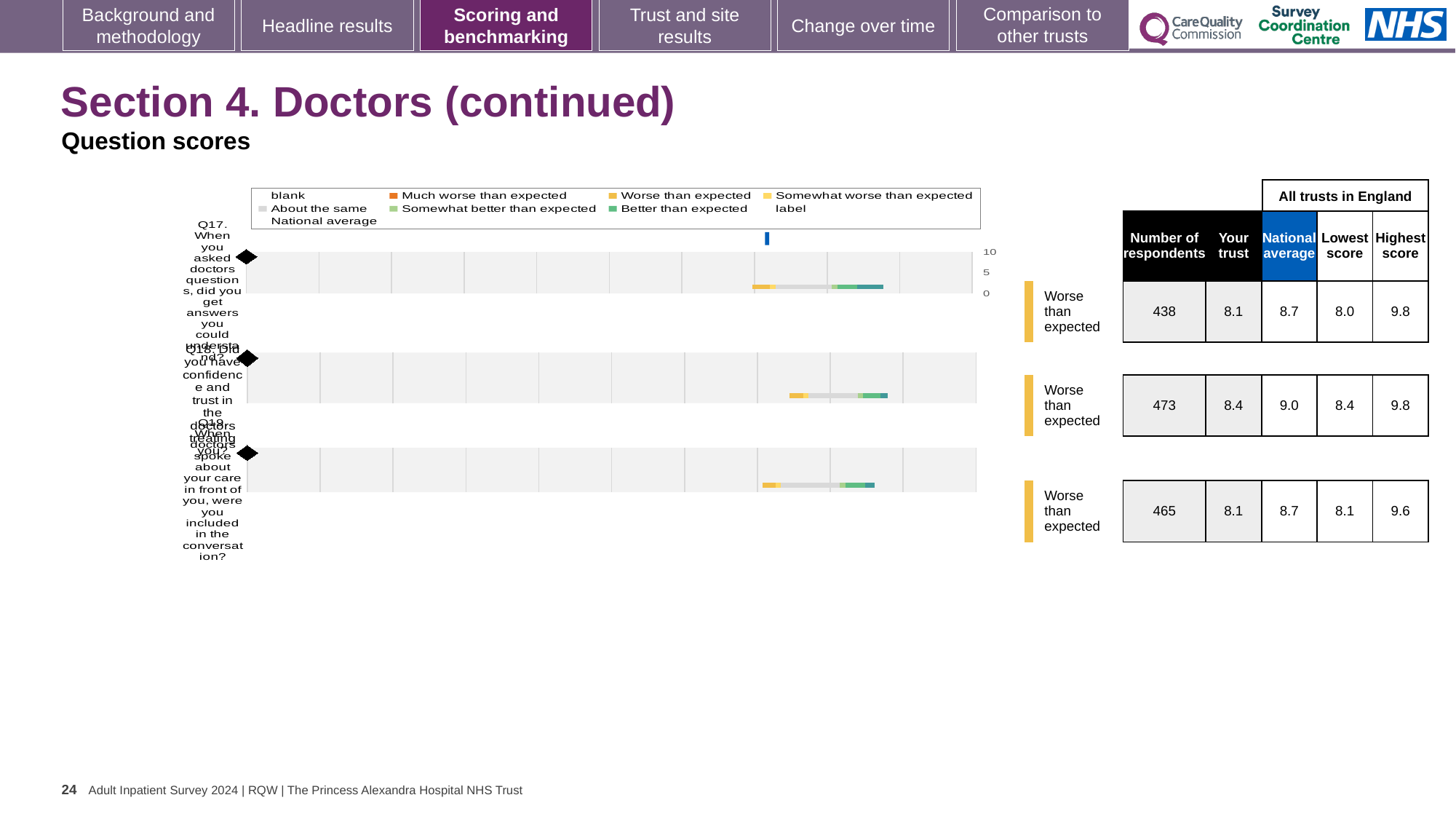
For Q17, is the 'Your trust' score higher or lower than the national average? lower How many respondents answered Q19 (When doctors spoke about your care in front of you, were you included in the conversation?)? 465 Which of the three questions has the highest 'Your trust' score? Q18 How many question charts (Q17, Q18, Q19) are shown on the slide? 3 What is the lowest score across all trusts in England for Q17? 8.0 Which of the three questions has the most respondents? Q18 What benchmark category is shown for Q17 (When you asked doctors questions, did you get answers you could understand?)? Worse than expected What is the difference between the national average and the 'Your trust' score for Q18? 0.6 What is the highest score across all trusts in England for Q19? 9.6 What is the 'Your trust' score for Q18 (Did you have confidence and trust in the doctors treating you?)? 8.4 Is the 'Your trust' score for Q17 greater or less than 5 on the chart axis? greater What is the national average score for Q17? 8.7